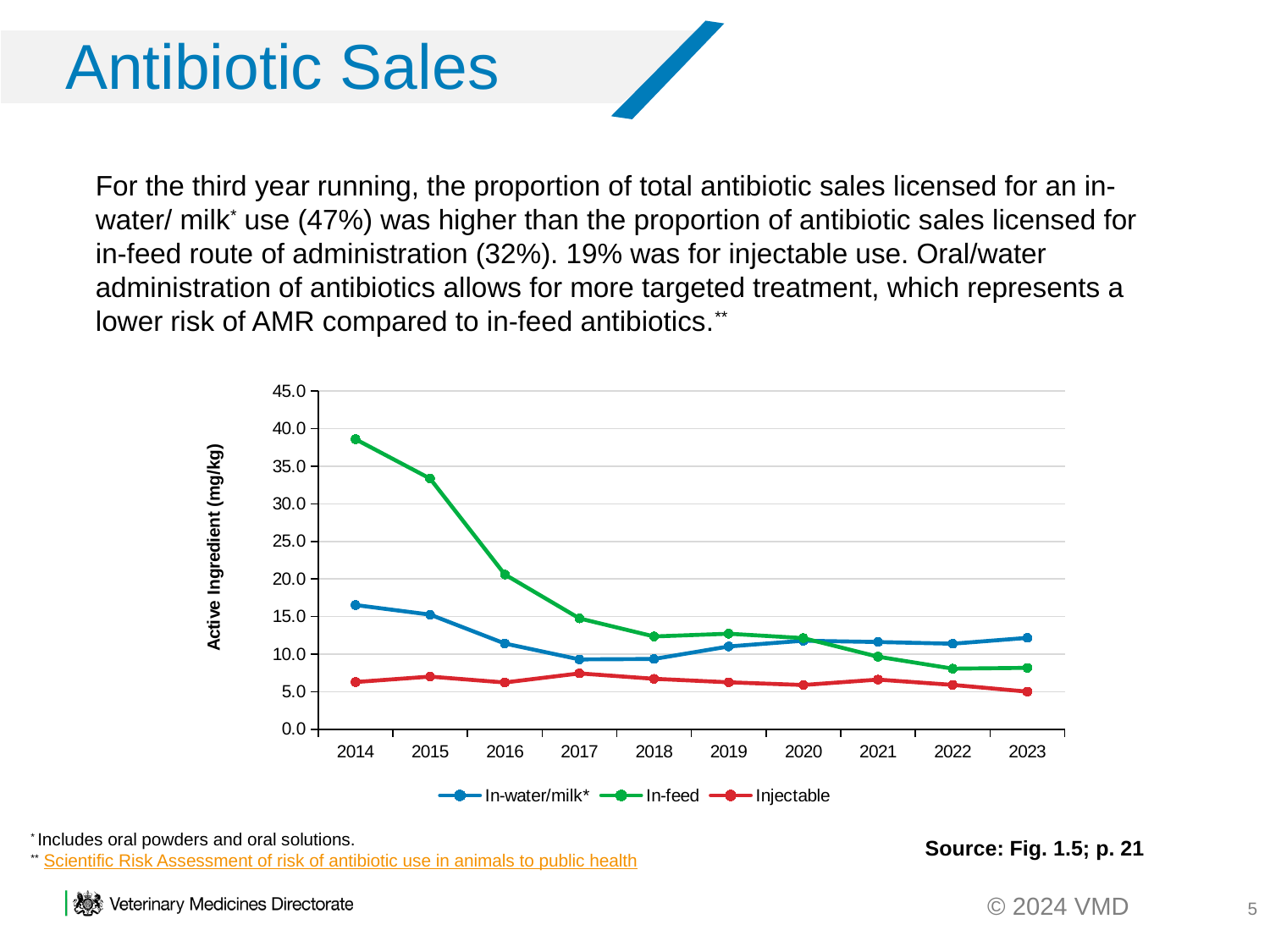
What is the label on the y axis of the chart? Active Ingredient (mg/kg) Which series has the higher value in 2023, In-water/milk* or In-feed? In-water/milk* Is the In-feed value for 2014 greater or less than 35.0? greater Which series has the lowest value in 2014? Injectable How many years are plotted along the x axis of the chart? 10 In which year is the In-feed value highest? 2014 Is the In-feed value for 2022 greater or less than 10.0? less How many series does the chart legend list? 3 In which year is the In-water/milk* value highest? 2014 What kind of chart is shown on the slide? line chart Does the In-feed line rise or fall from 2014 to 2023? fall Is the In-water/milk* value for 2014 greater or less than 15.0? greater